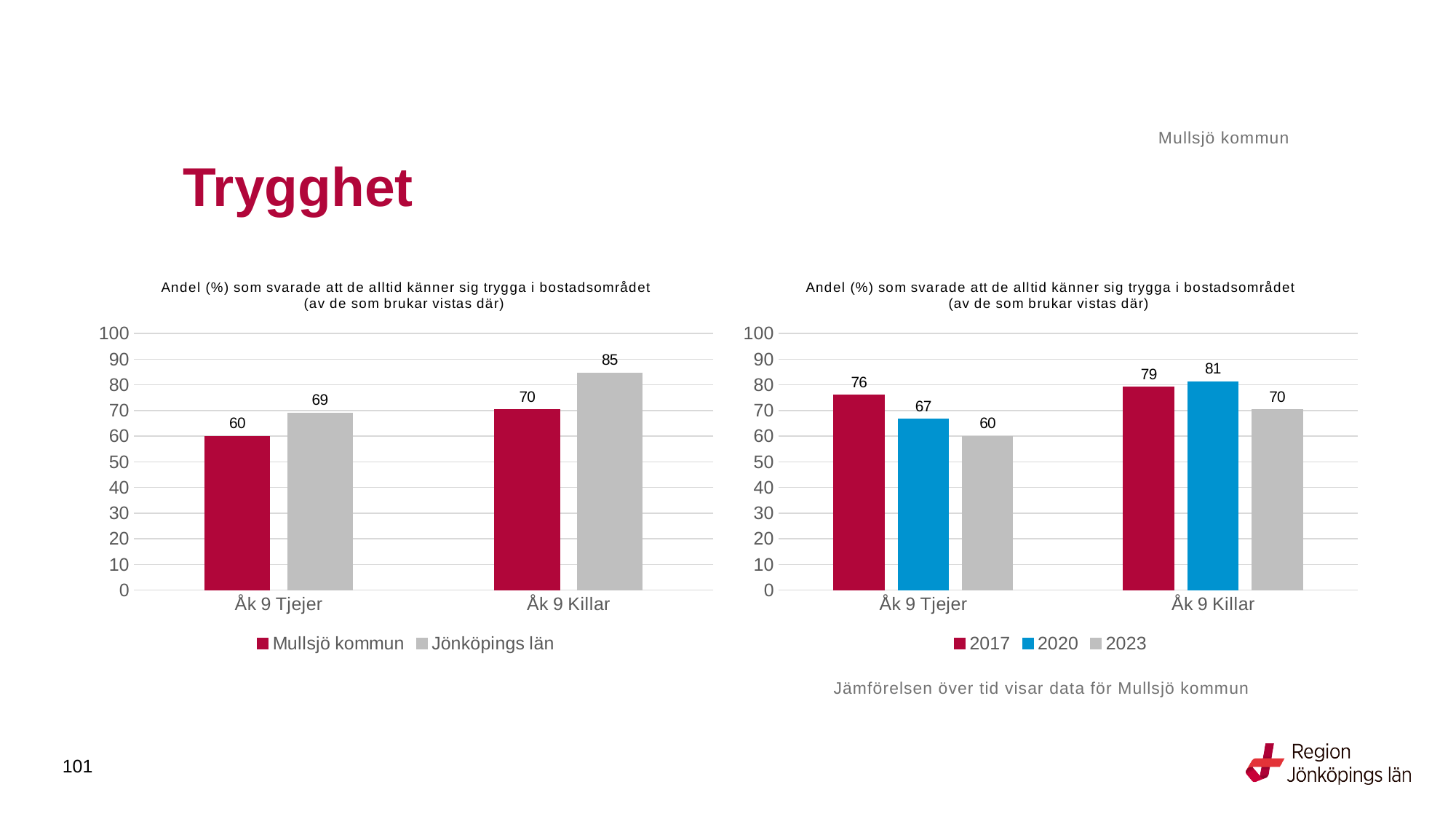
What kind of chart is the right chart? bar chart In the right chart, do the values for Åk 9 Tjejer rise or fall from 2017 to 2023? fall In the left chart, what is the value for Jönköpings län for Åk 9 Killar? 85 In the left chart, what is the difference between Jönköpings län and Mullsjö kommun for Åk 9 Killar? 15 In the right chart, what is the value for 2017 for Åk 9 Tjejer? 76 In the left chart, what is the value for Mullsjö kommun for Åk 9 Tjejer? 60 In the right chart, which year has the lowest value for Åk 9 Tjejer? 2023 In the left chart, how many series does the legend list? 2 In the right chart, what is the difference between the 2017 and 2023 values for Åk 9 Tjejer? 16 In the left chart, which is larger for Åk 9 Tjejer: Mullsjö kommun or Jönköpings län? Jönköpings län In the right chart, what is the value for 2023 for Åk 9 Killar? 70 In the right chart, which year has the highest value for Åk 9 Killar? 2020